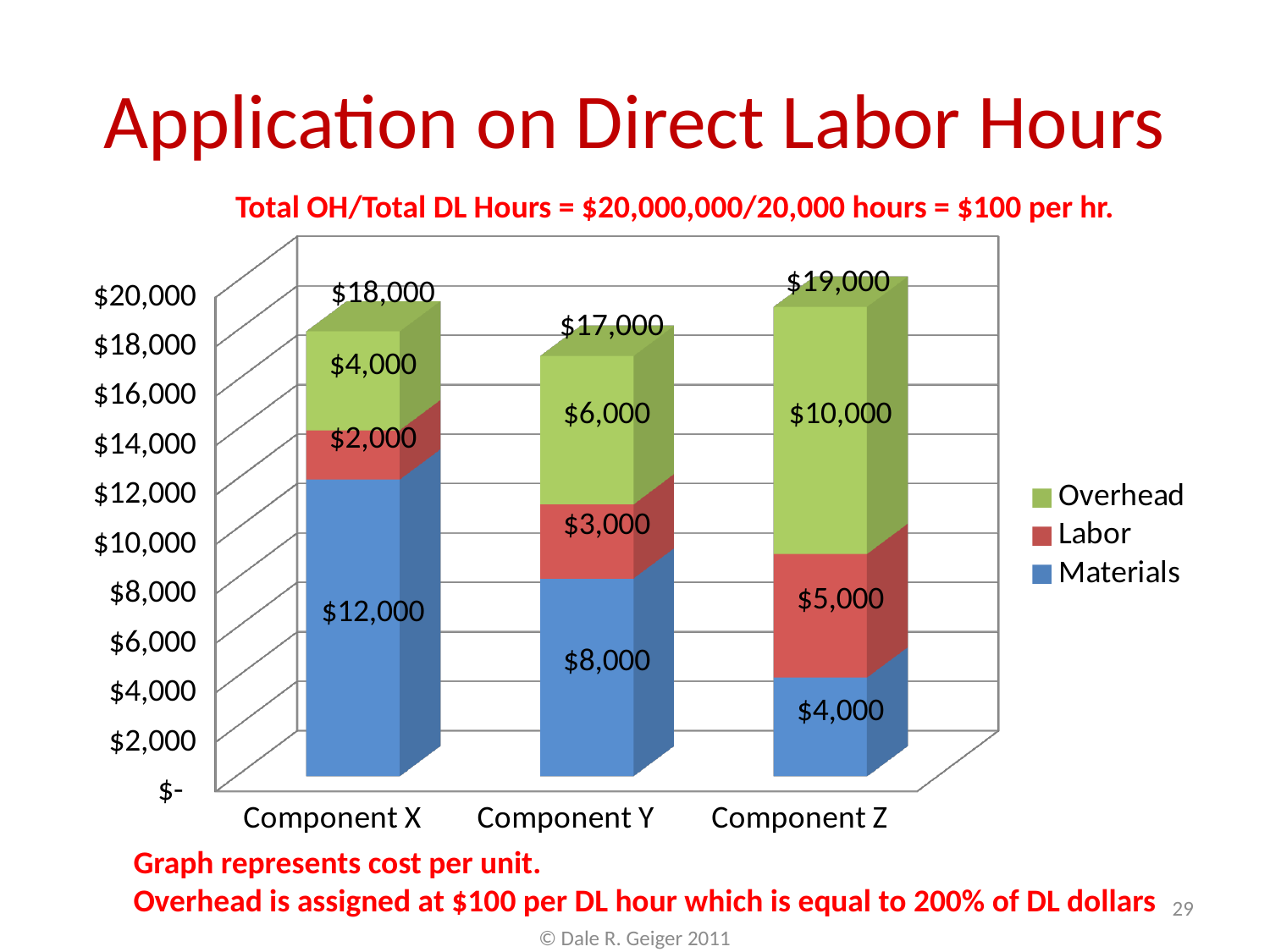
How many series does the legend list? 3 What is the difference between the Overhead cost of Component Z and Component X? $6,000 Which colour represents Overhead in the chart? Green Which is larger, the Labor cost for Component Z or the Labor cost for Component X? Component Z Which component has the highest total cost per unit? Component Z What is the Overhead cost for Component Z? $10,000 What kind of chart is shown on the slide? Stacked bar chart Which component has the lowest Materials cost? Component Z What is the Labor cost for Component Y? $3,000 What is the total cost per unit for Component Y? $17,000 What is the Materials cost for Component X? $12,000 How many components are shown on the x axis? 3